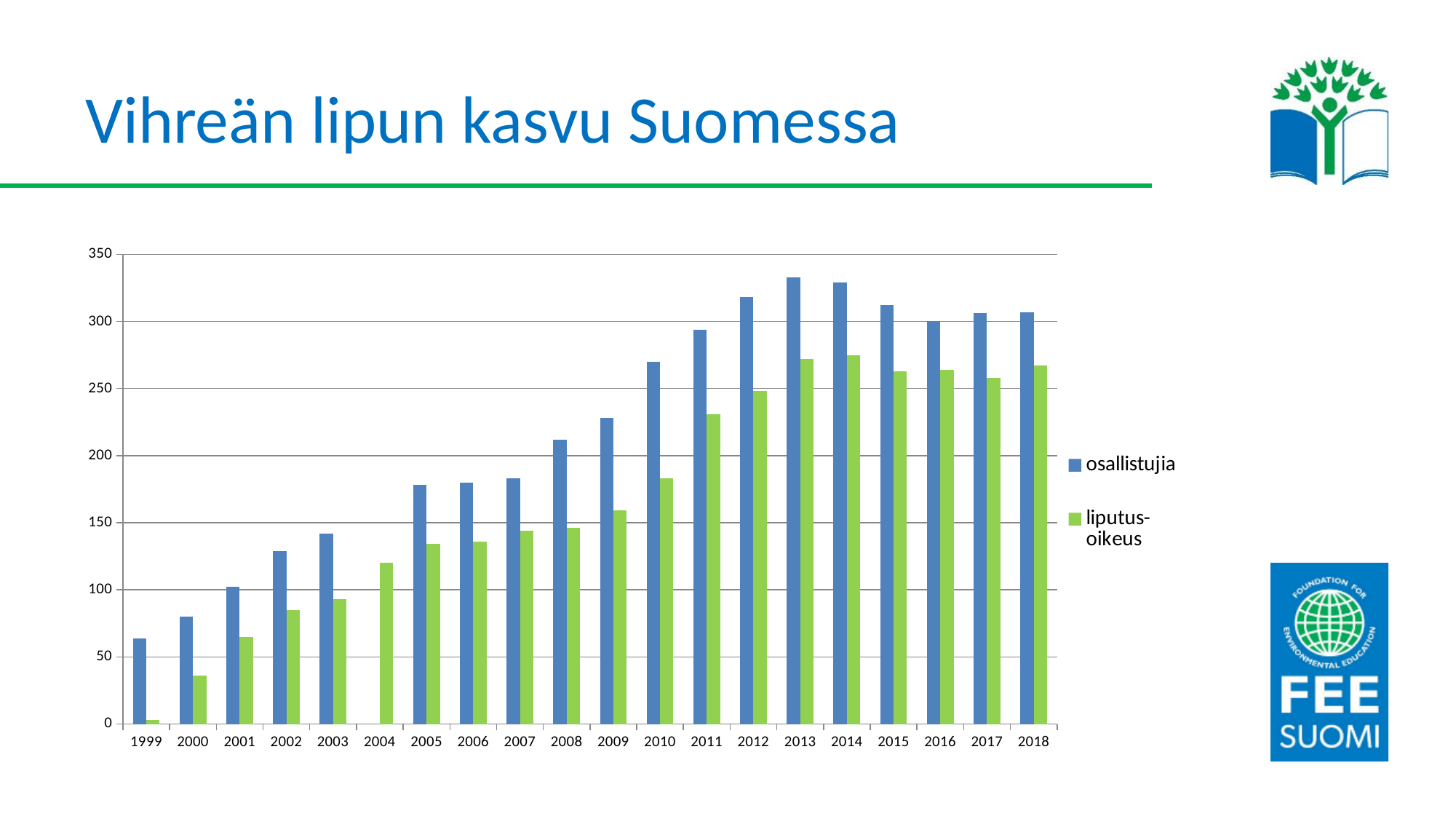
Is the osallistujia value for 2003 greater or less than 150? less Which year has the lowest liputus-oikeus value? 1999 Which year has the lowest osallistujia value? 1999 Which is larger, the osallistujia value for 2008 or for 2009? 2009 How many years are shown on the x axis? 20 Is the osallistujia value for 2010 greater or less than 250? greater Is the liputus-oikeus value for 2009 greater or less than 150? greater What kind of chart is shown on the slide? bar chart Which year has no osallistujia bar shown? 2004 Do the osallistujia values rise or fall from 1999 to 2013? rise How many series does the legend list? 2